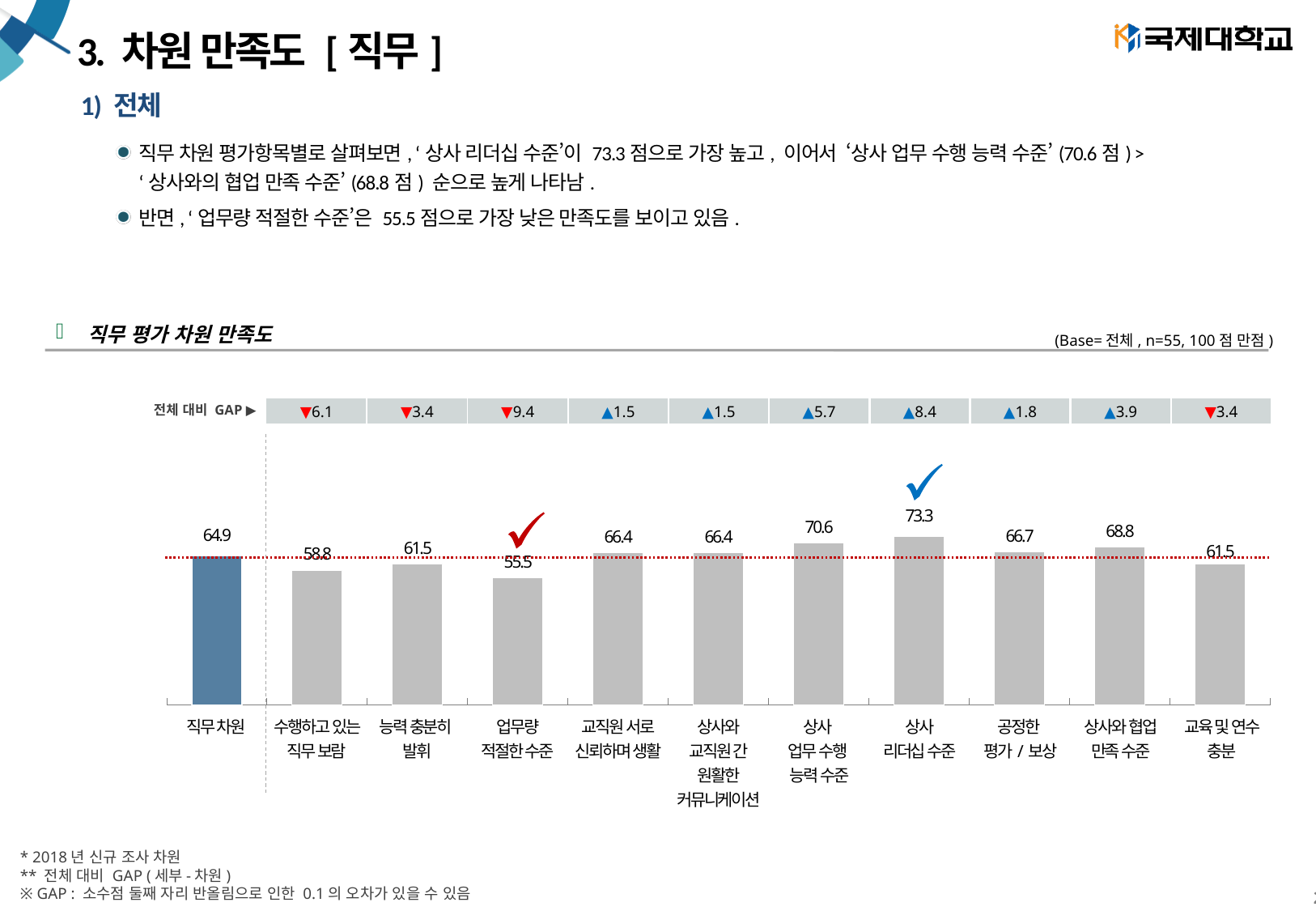
What is the value for '업무량 적절한 수준' in the chart? 55.5 Which is larger, the value for '상사 업무 수행 능력 수준' or the value for '상사와 협업 만족 수준'? 상사 업무 수행 능력 수준 What is the value for '상사 리더십 수준' in the chart? 73.3 What kind of chart is shown on the slide? Bar chart How many bars are plotted in the chart? 11 Which category has the lowest value in the chart? 업무량 적절한 수준 Which category has the highest value in the chart? 상사 리더십 수준 What is the difference between the values for '상사 리더십 수준' and '업무량 적절한 수준'? 17.8 What is the value of the '직무차원' bar in the chart? 64.9 What is the title of the chart on the slide? 직무 평가 차원 만족도 What is the GAP value shown above the '상사 리더십 수준' bar? ▲8.4 What is the GAP value shown above the '업무량 적절한 수준' bar? ▼9.4